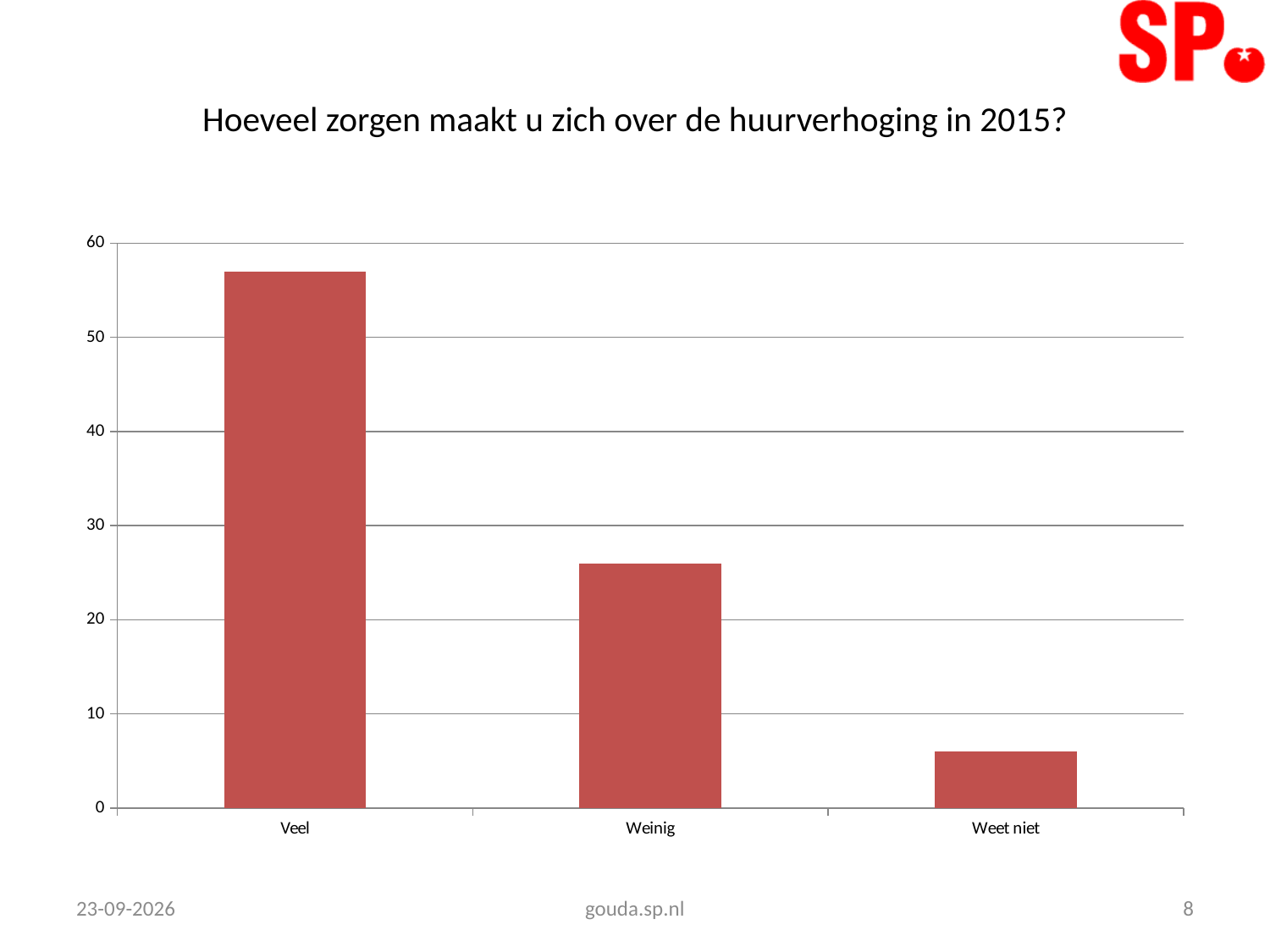
How many categories are shown on the x axis of the chart? 3 What is the title of the chart on the slide? Hoeveel zorgen maakt u zich over de huurverhoging in 2015? Do the bar values rise or fall from left to right along the x axis? fall Is the value for Veel greater or less than 50? greater What kind of chart is shown on the slide? bar chart Is the value for Weinig greater or less than 20? greater Which is larger, the value for Weinig or the value for Weet niet? Weinig Is the value for Weet niet greater or less than 10? less Which category has the lowest bar? Weet niet Which category has the highest bar? Veel Which is larger, the value for Veel or the value for Weinig? Veel